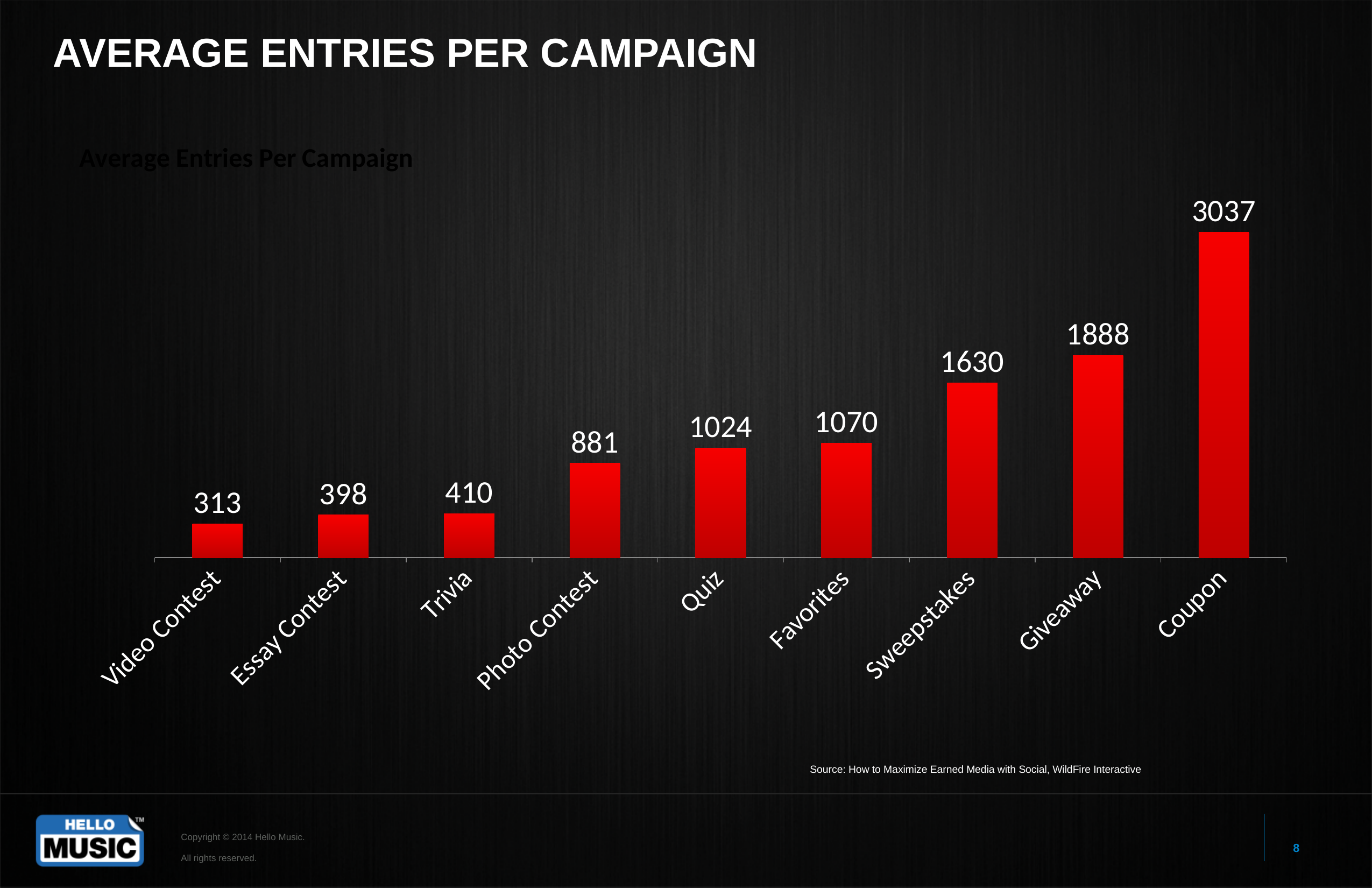
What is the average number of entries per campaign for Photo Contest? 881 Which has more average entries, Trivia or Essay Contest? Trivia How many campaign types are shown in the chart? 9 Which campaign type has the highest average entries? Coupon Which has more average entries, Quiz or Favorites? Favorites What is the average number of entries per campaign for Sweepstakes? 1630 Do the values rise or fall from left to right across the campaign types? Rise Which campaign type has the lowest average entries? Video Contest What is the average number of entries per campaign for Coupon? 3037 What kind of chart is shown on the slide? Bar chart What is the difference in average entries between Giveaway and Sweepstakes? 258 What is the difference in average entries between Coupon and Video Contest? 2724